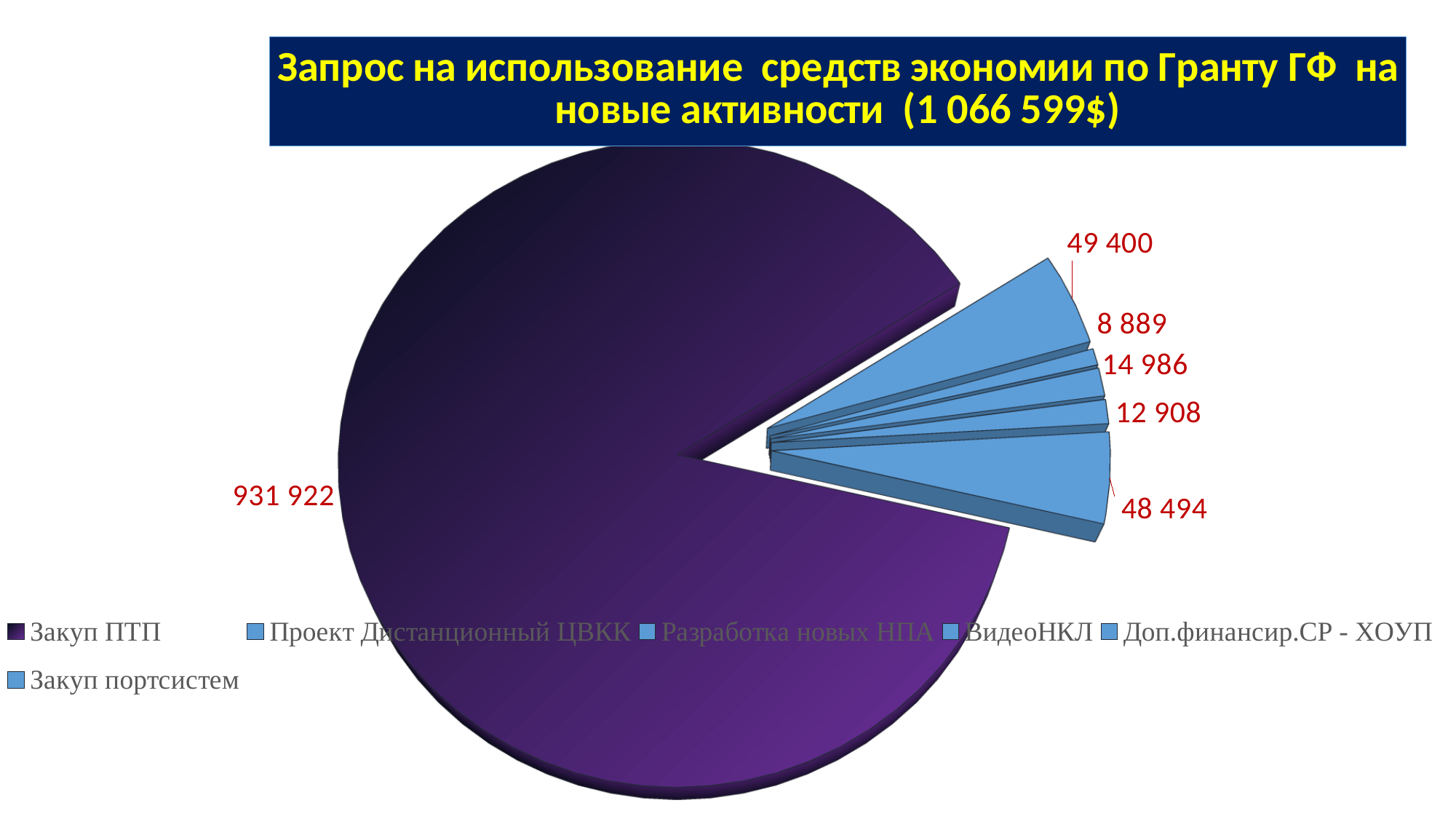
What share of the pie does the Закуп ПТП slice (931 922) represent, to one decimal place? 87.4% Which is larger, the slice labelled 49 400 or the slice labelled 48 494? 49 400 How many slices does the pie chart have? 6 What total amount is stated in the chart title? 1 066 599$ Which category has the largest slice in the pie chart? Закуп ПТП How many entries does the legend list? 6 What is the value of the Закуп ПТП slice? 931 922 What kind of chart is shown on the slide? pie chart What is the smallest value labelled on the pie chart? 8 889 What is the difference between the slices labelled 14 986 and 12 908? 2 078 What is the total of all the values labelled on the pie chart? 1 066 599 What is the difference between the slices labelled 49 400 and 48 494? 906